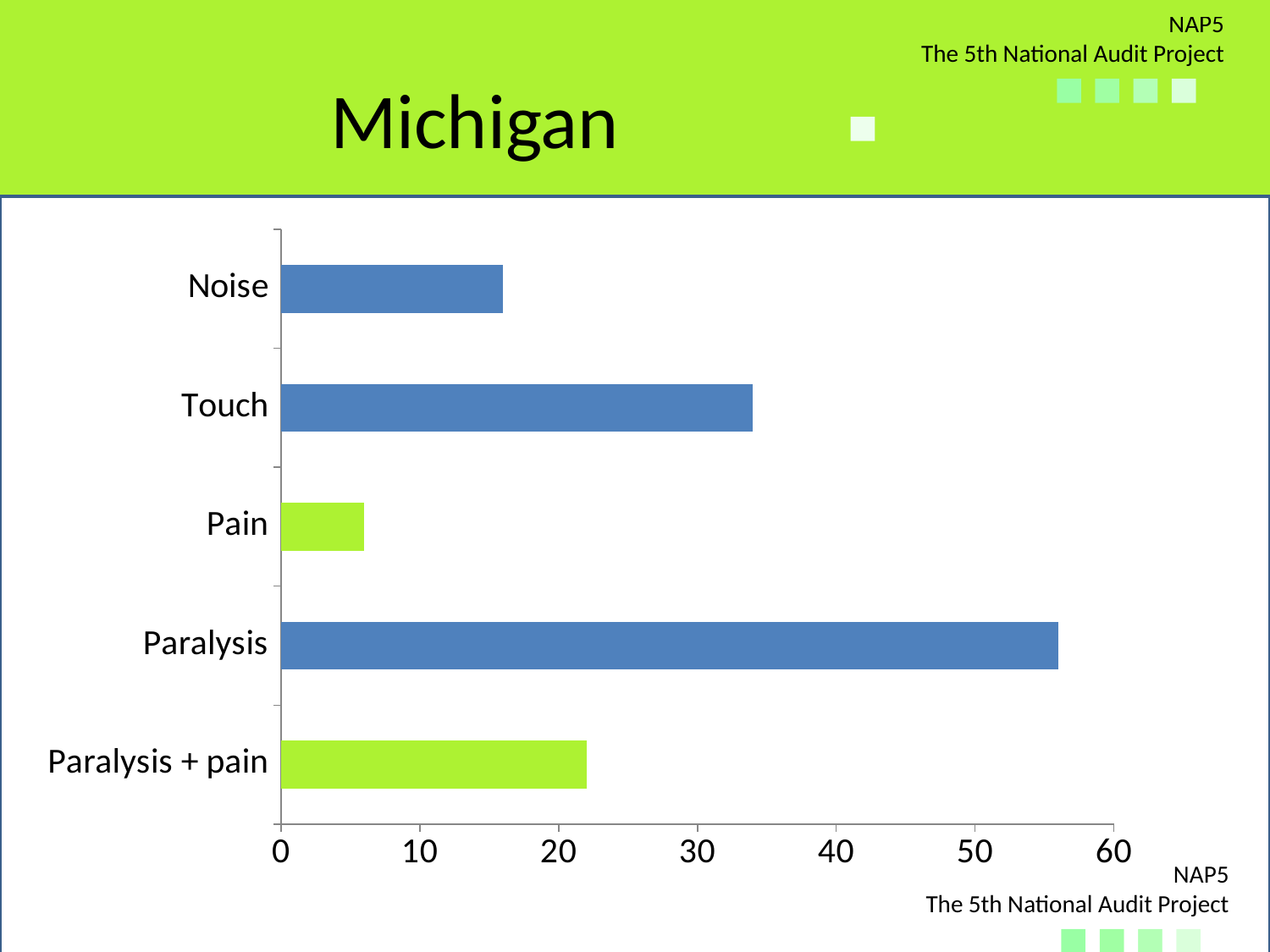
Is the value for Pain greater or less than 10? less Is the value for Paralysis greater or less than 50? greater Is the value for Paralysis + pain greater or less than 30? less Which categories are drawn with green bars rather than blue? Pain and Paralysis + pain What kind of chart is shown on the slide? bar chart Which category has the lowest value? Pain How many categories are plotted in the chart? 5 Which has the larger value, Touch or Noise? Touch Which category has the highest value? Paralysis What is the title of the chart? Michigan